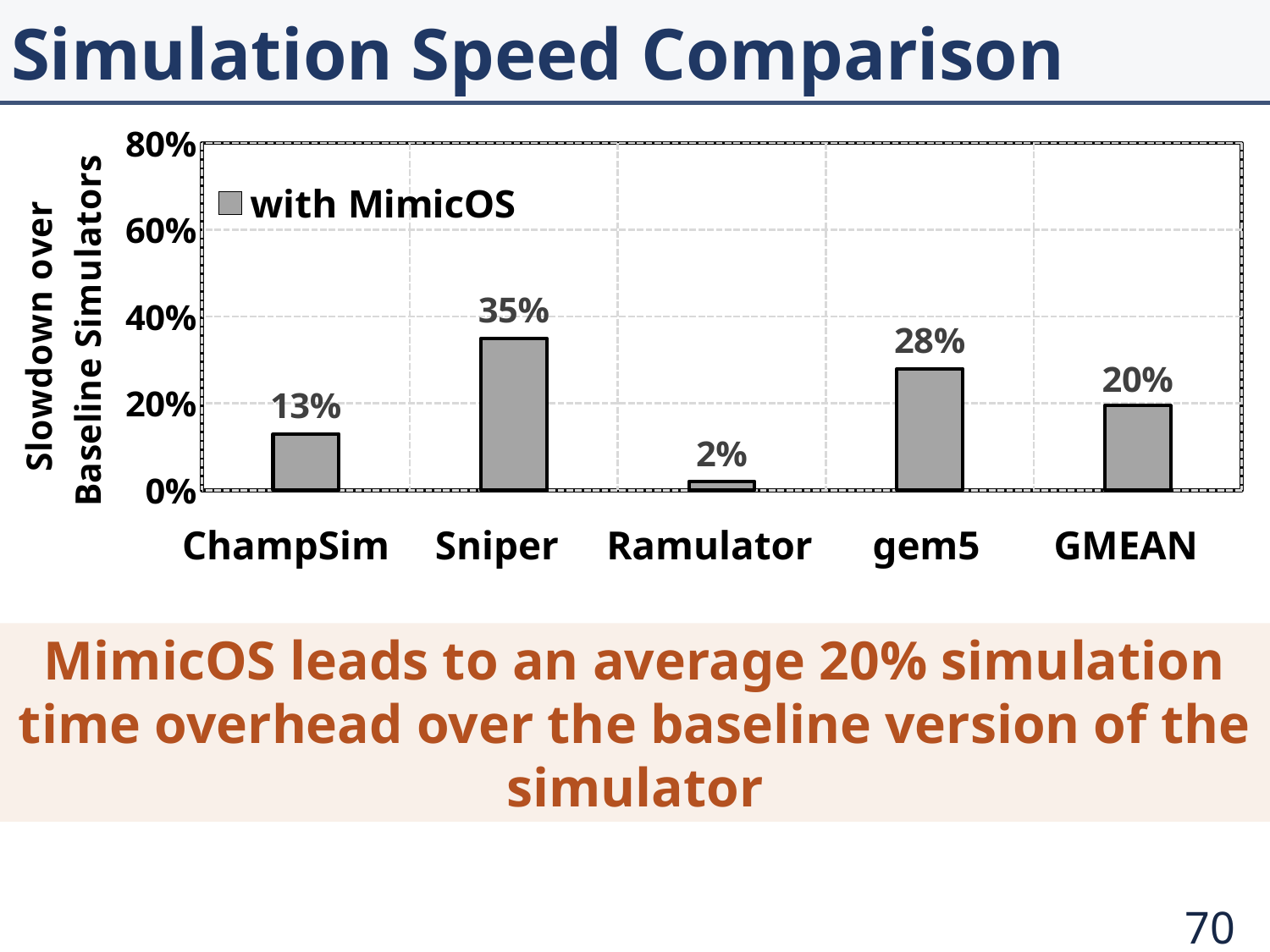
What is the slowdown value for Sniper? 35% What is the legend entry for the series in the chart? with MimicOS What is the slowdown value for gem5? 28% Which simulator has the highest slowdown? Sniper Which simulator has the lowest slowdown? Ramulator Which has a larger slowdown, ChampSim or gem5? gem5 What kind of chart is shown on the slide? bar chart What is the difference between the slowdown for Sniper and the slowdown for gem5? 7% What is the GMEAN slowdown value? 20% How many categories are shown on the x axis? 5 What is the slowdown value for ChampSim? 13% Is the value for Sniper greater or less than 40%? less